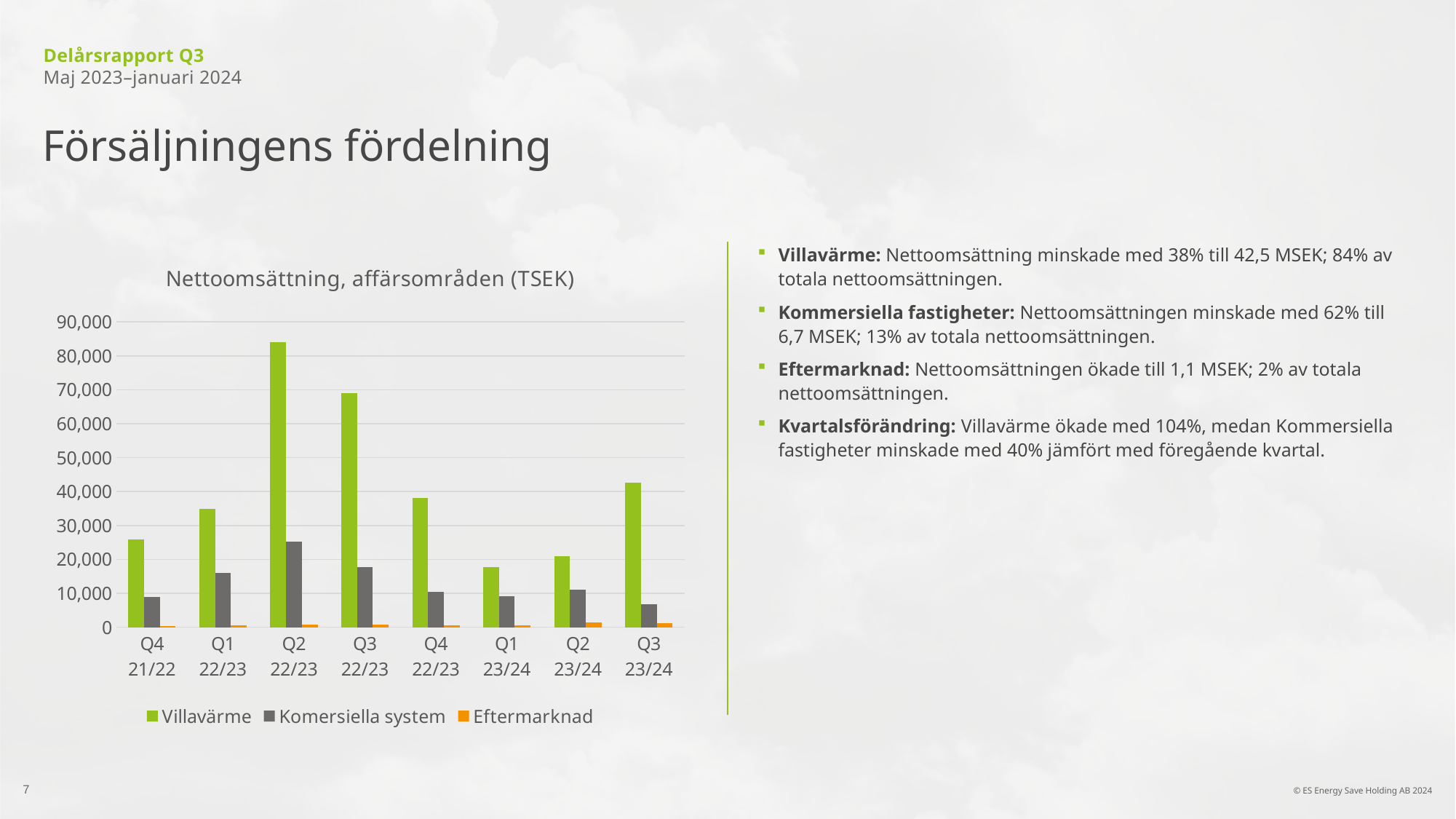
Is the Villavärme value for Q3 23/24 greater or less than 50,000? less Is the Villavärme value for Q2 22/23 greater or less than 80,000? greater Is the Komersiella system value for Q2 22/23 greater or less than 20,000? greater In which quarter is the Komersiella system bar highest? Q2 22/23 Which quarter has the larger Villavärme value, Q3 22/23 or Q4 22/23? Q3 22/23 In which quarter is the Villavärme bar highest? Q2 22/23 How many series does the legend of the chart list? 3 In which quarter is the Komersiella system bar lowest? Q3 23/24 How many quarters are shown on the x axis of the chart? 8 What is the title of the chart? Nettoomsättning, affärsområden (TSEK) In which quarter is the Villavärme bar lowest? Q1 23/24 What kind of chart is shown on the slide? Bar chart